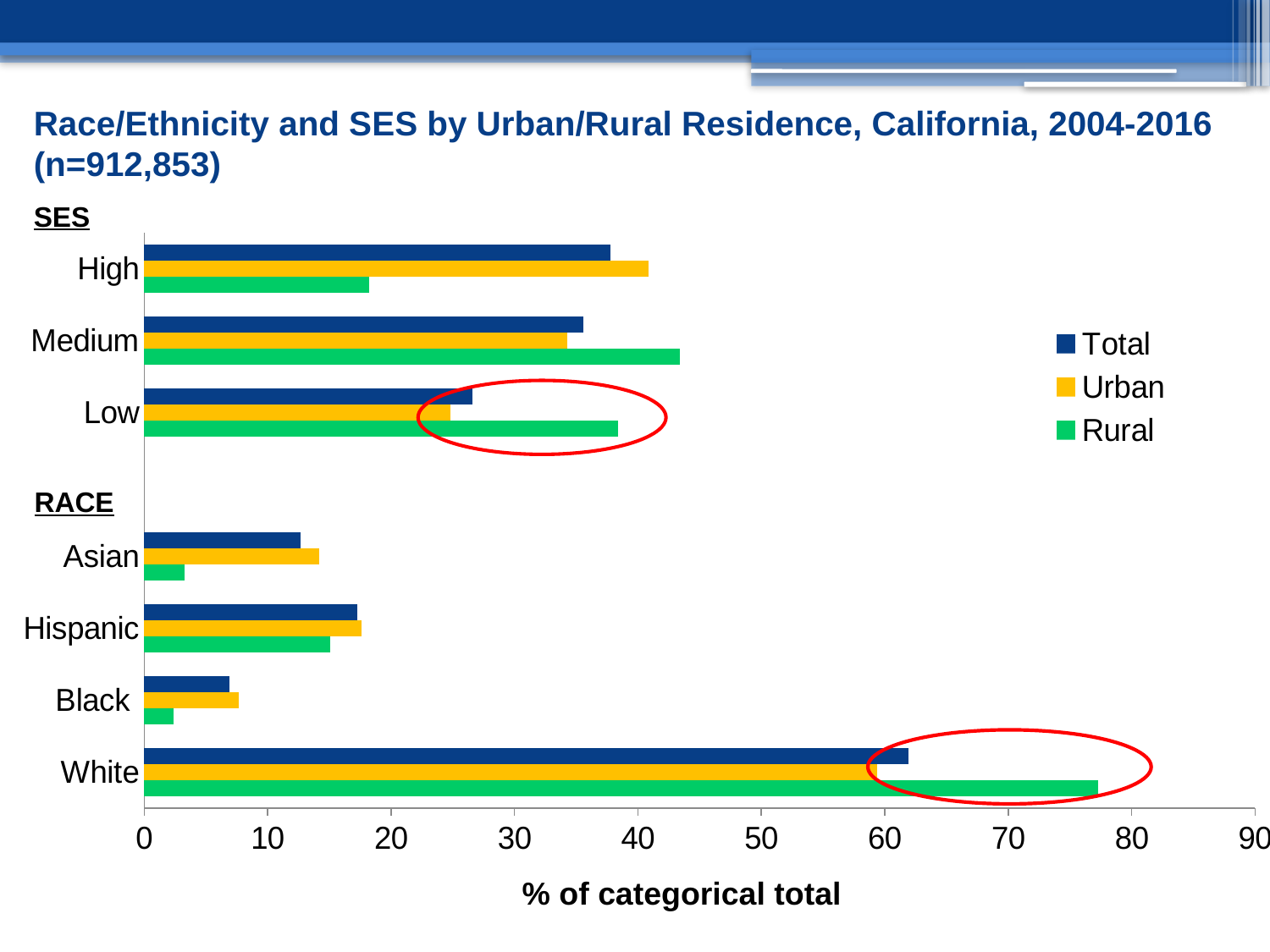
Is the Rural value for Asian greater or less than 10? less Which category has the lowest Rural value? Black How many categories are plotted on the chart? 7 Is the Urban value for High SES greater or less than 40? greater Which is larger for Low SES, the Urban value or the Rural value? Rural How many series does the legend list? 3 Which category has the highest Rural value? White Is the Rural value for White greater or less than 70? greater Which is larger for High SES, the Urban value or the Rural value? Urban What kind of chart is shown on the slide? bar chart What is the label of the x axis? % of categorical total